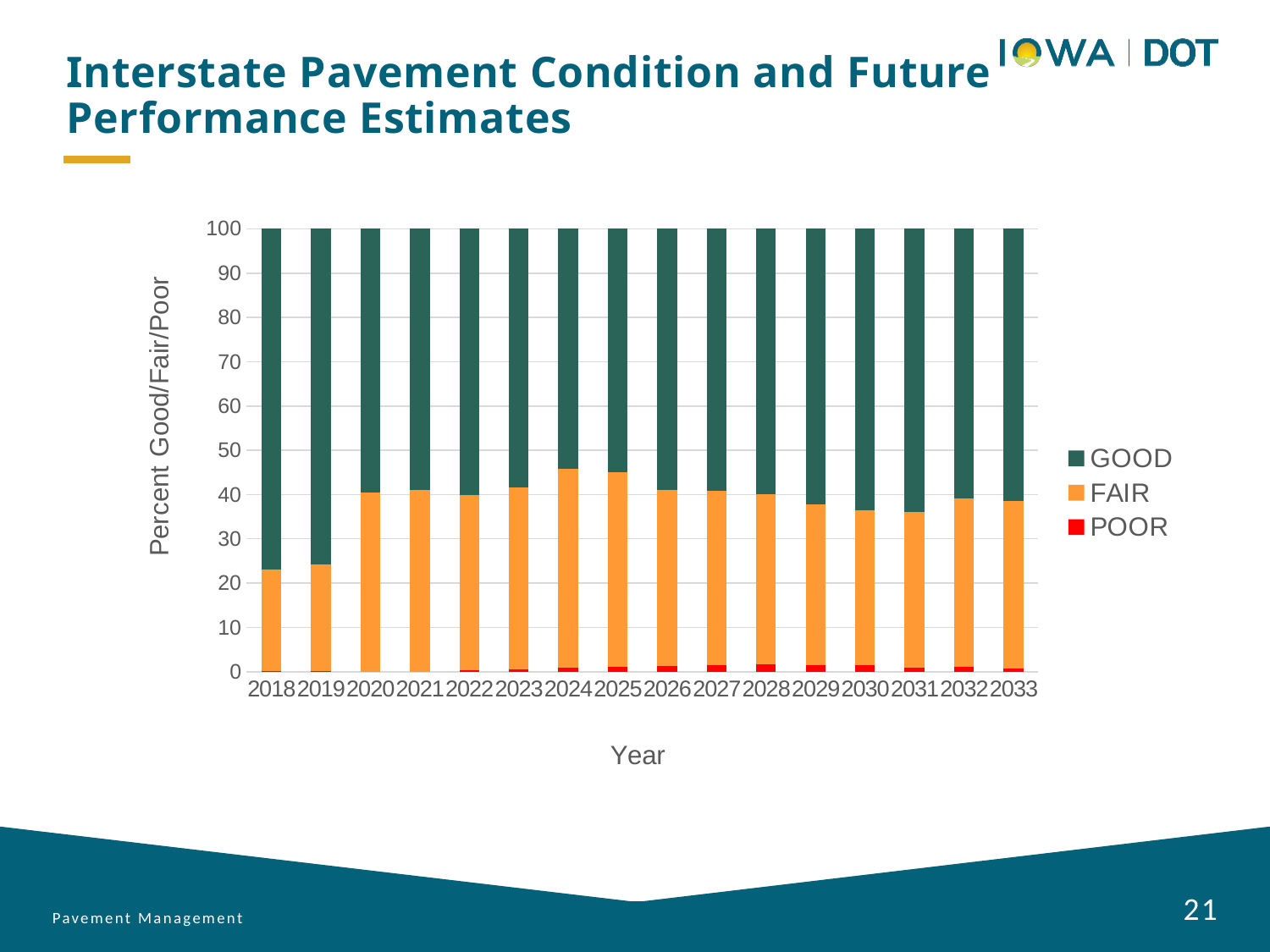
Which year has a larger FAIR segment, 2018 or 2024? 2024 What is the title of the vertical axis? Percent Good/Fair/Poor What kind of chart is shown on the slide? Stacked bar chart Is the top of the FAIR segment for 2018 greater or less than 30? less Does the GOOD share rise or fall from 2018 to 2020? Fall Which year has the largest GOOD segment? 2018 Is the top of the FAIR segment for 2024 greater or less than 40? greater Which year has the smallest FAIR segment? 2018 How many series does the legend list? 3 Is the top of the FAIR segment for 2031 greater or less than 40? less What is the total height of the stacked bar for 2018? 100 How many years are shown along the x axis? 16